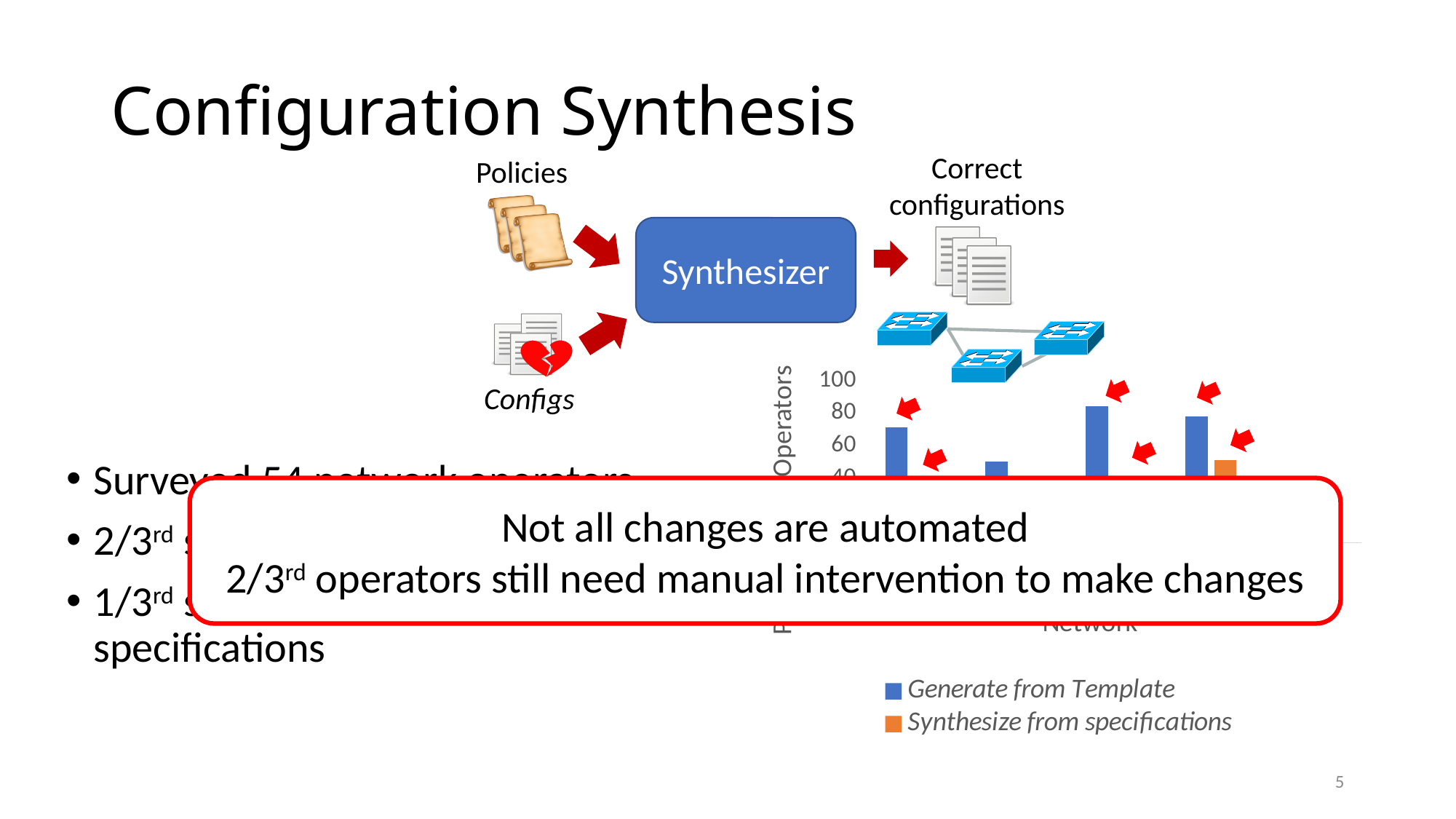
Which colour represents the 'Synthesize from specifications' series in the chart? orange What are the two series named in the chart's legend? Generate from Template; Synthesize from specifications Is the value of the second blue 'Generate from Template' bar from the left greater or less than 60? less Is the value of the leftmost blue 'Generate from Template' bar greater or less than 60? greater Is the value of the tallest blue 'Generate from Template' bar greater or less than 100? less How many series does the chart's legend list? 2 What is the highest tick value shown on the chart's y-axis? 100 What kind of chart is shown on the slide? bar chart In the rightmost group of bars, which series has the taller bar, 'Generate from Template' or 'Synthesize from specifications'? Generate from Template